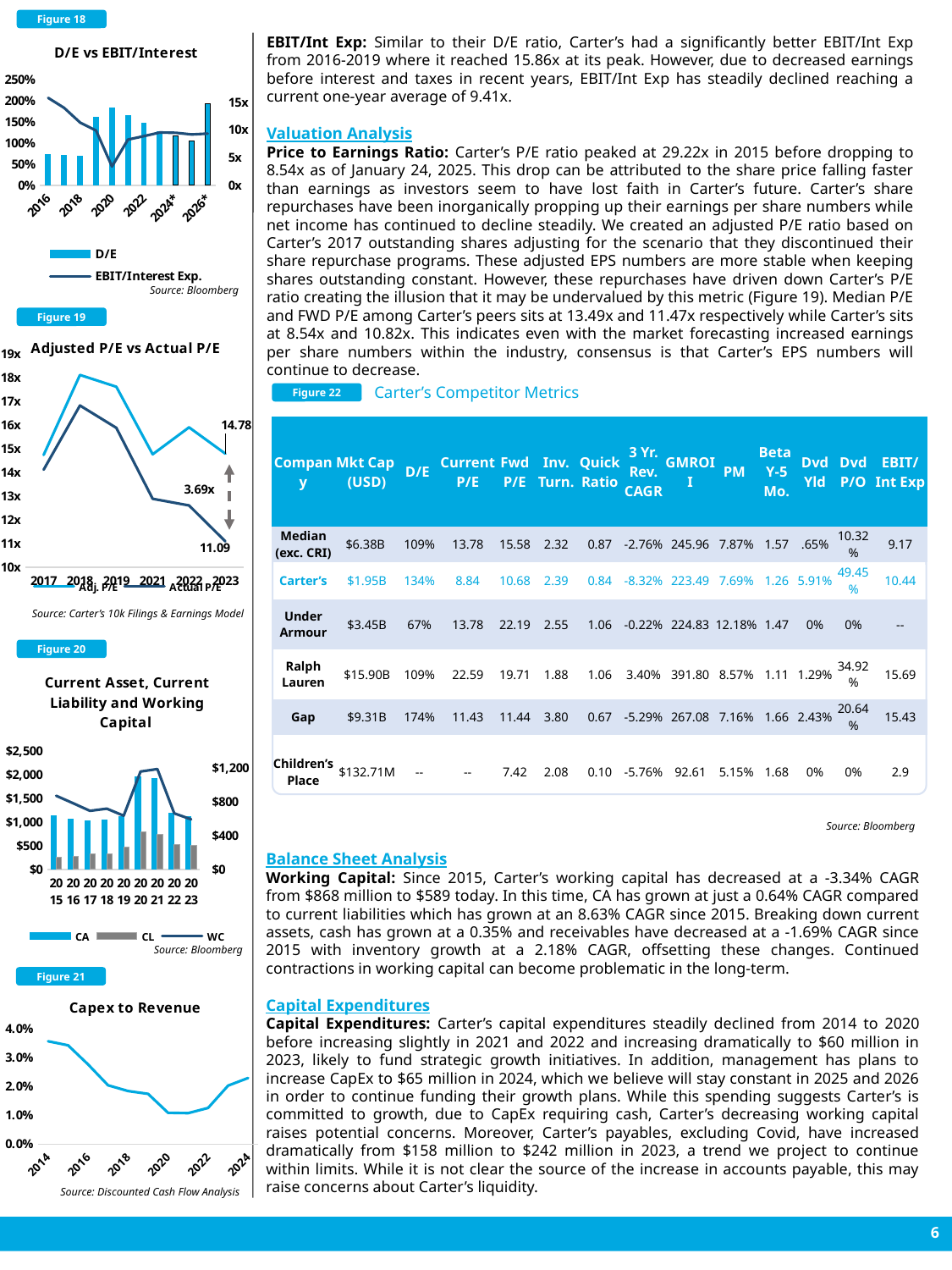
In the 'Current Asset, Current Liability and Working Capital' chart (Figure 20), in which year is CA highest? 2020 How many series does the legend of the 'D/E vs EBIT/Interest' chart (Figure 18) list? 2 What kind of chart is the 'Capex to Revenue' chart (Figure 21)? line chart In the 'Adjusted P/E vs Actual P/E' chart (Figure 19), what is the Adj. P/E value labelled for 2023? 14.78 In the 'D/E vs EBIT/Interest' chart (Figure 18), is the D/E value for 2016 greater or less than 100%? less In the 'Adjusted P/E vs Actual P/E' chart (Figure 19), in which year is Adj. P/E highest? 2018 In the 'Adjusted P/E vs Actual P/E' chart (Figure 19), what is the labelled gap between Adj. P/E and Actual P/E in 2023? 3.69x In the 'Capex to Revenue' chart (Figure 21), does the value rise or fall from 2014 to 2020? fall In the 'Adjusted P/E vs Actual P/E' chart (Figure 19), how many years are shown on the x axis? 6 In the 'D/E vs EBIT/Interest' chart (Figure 18), is the D/E value for 2020 greater or less than 150%? greater In the 'Adjusted P/E vs Actual P/E' chart (Figure 19), what is the Actual P/E value labelled for 2023? 11.09 How many series does the legend of the 'Current Asset, Current Liability and Working Capital' chart (Figure 20) list? 3